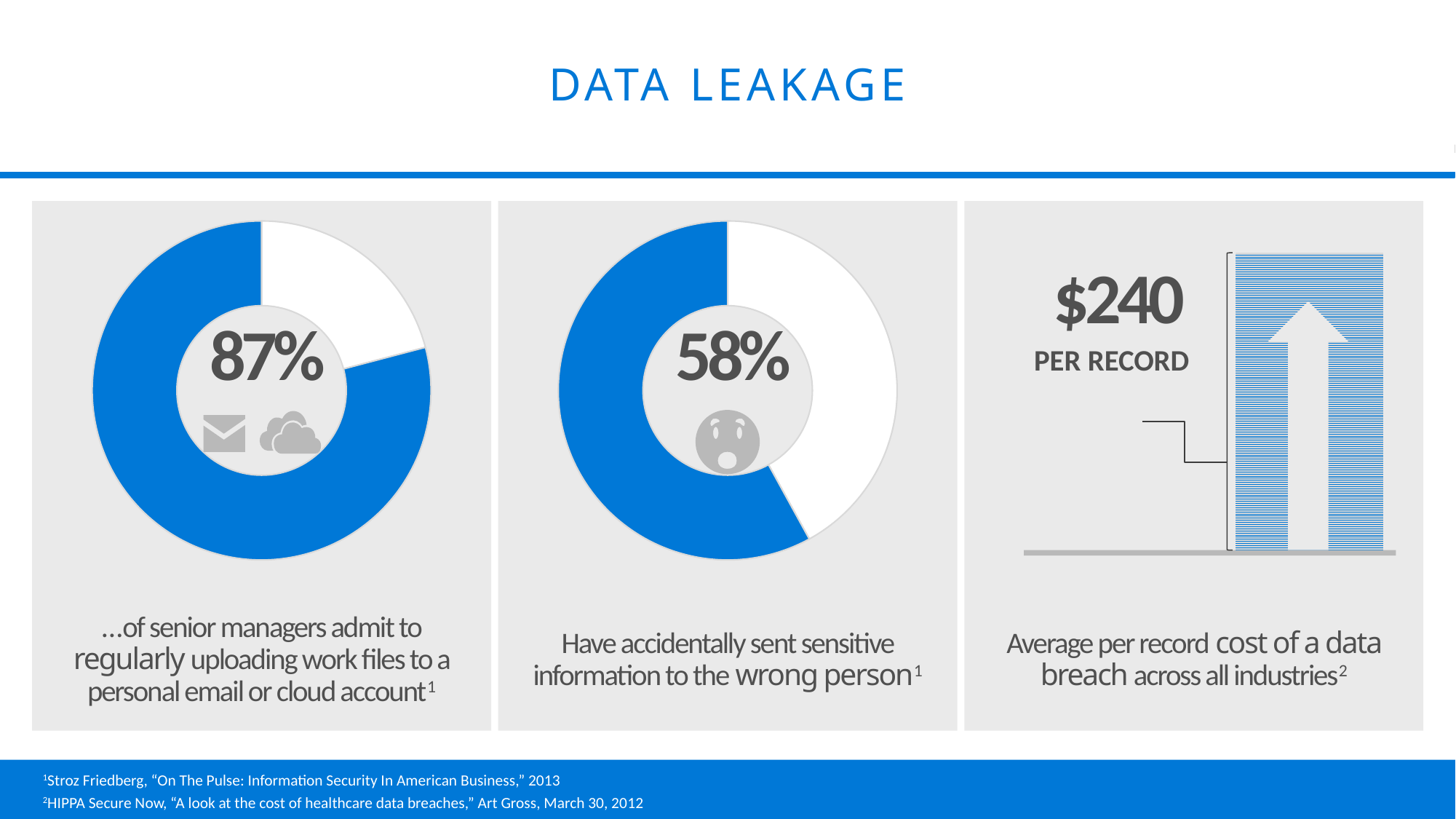
Is the value shown on the left donut chart greater or less than 80%? greater What colour is used for the filled portion of the donut charts? Blue Which is larger: the percentage on the left donut chart or the percentage on the middle donut chart? The left donut chart (87%) What kind of chart is used in the left and middle panels of the slide? Donut (pie) chart On the right panel, what unit label appears directly below the $240 figure? PER RECORD On the left donut chart, what percentage of senior managers admit to regularly uploading work files to a personal email or cloud account? 87% What is the title of the slide containing the charts? DATA LEAKAGE How many donut charts are shown on the slide? 2 What is the difference in percentage points between the left donut chart value (87%) and the middle donut chart value (58%)? 29 percentage points Is the value shown on the middle donut chart greater or less than 50%? greater On the middle donut chart, what percentage have accidentally sent sensitive information to the wrong person? 58% On the right panel, what is the average per record cost of a data breach across all industries? $240